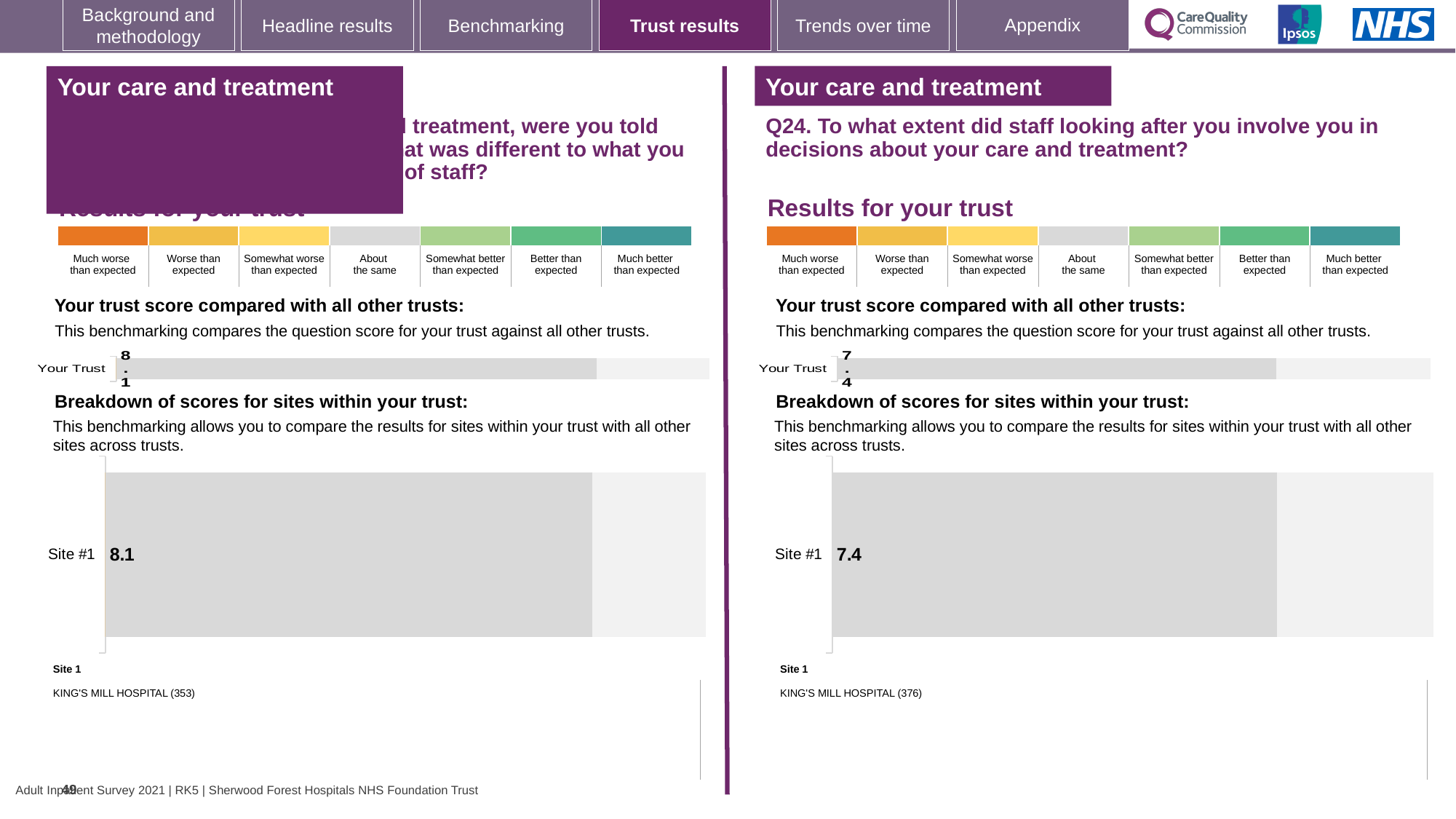
In the left 'Breakdown of scores for sites within your trust' chart, what is the score for Site #1? 8.1 How many sites are shown in the Q24 'Breakdown of scores for sites within your trust' chart on the right? 1 How many sites are shown in the left 'Breakdown of scores for sites within your trust' chart? 1 Which is larger: the Your Trust score on the left half of the slide or the Your Trust score for Q24 on the right half? The left half (8.1) In the Q24 'Breakdown of scores for sites within your trust' chart on the right, what is the score for Site #1? 7.4 On the right half of the slide (Q24), what is the score shown for Your Trust? 7.4 Which hospital is listed as Site 1 on the right half of the slide, and how many respondents are shown in brackets? KING'S MILL HOSPITAL (376) On the left half of the slide, what is the score shown for Your Trust? 8.1 How many respondents are shown in brackets for KING'S MILL HOSPITAL on the left half of the slide? 353 What is the difference between the Site #1 score on the left chart and the Site #1 score on the right (Q24) chart? 0.7 What kind of chart is used to show the Site #1 score on the right half of the slide? Bar chart